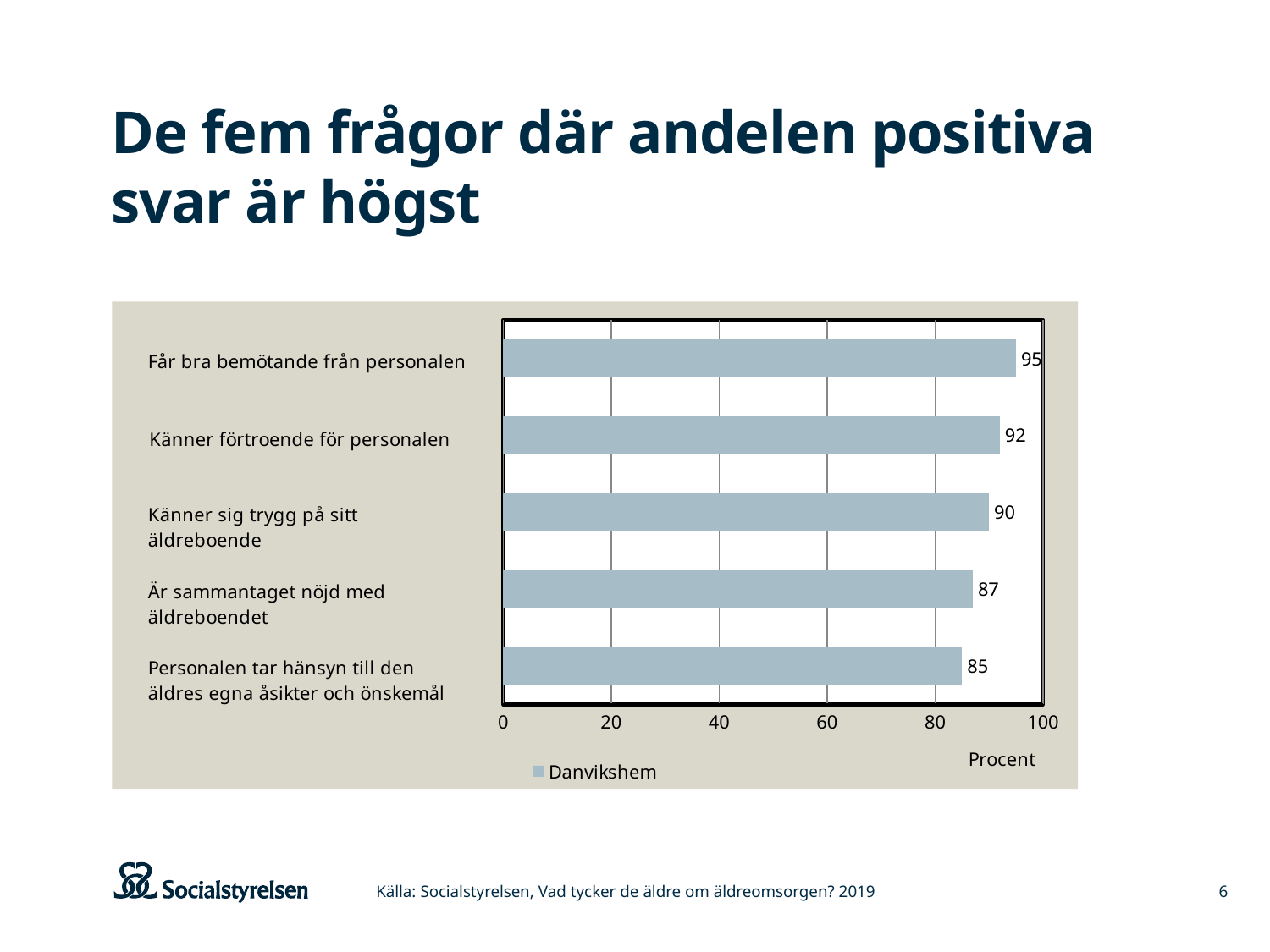
Which category has the lowest value? Personalen tar hänsyn till den äldres egna åsikter och önskemål What is the value for "Känner förtroende för personalen"? 92 What is the value for "Får bra bemötande från personalen"? 95 What is the value for "Känner sig trygg på sitt äldreboende"? 90 Which category has the highest value? Får bra bemötande från personalen What kind of chart is shown on the slide? bar chart What series name does the legend show? Danvikshem Is the value for "Är sammantaget nöjd med äldreboendet" greater or less than 80? greater What is the difference between the values for "Får bra bemötande från personalen" and "Är sammantaget nöjd med äldreboendet"? 8 How many categories are shown in the chart? 5 What is the value for "Personalen tar hänsyn till den äldres egna åsikter och önskemål"? 85 Which is larger, the value for "Känner förtroende för personalen" or the value for "Är sammantaget nöjd med äldreboendet"? Känner förtroende för personalen